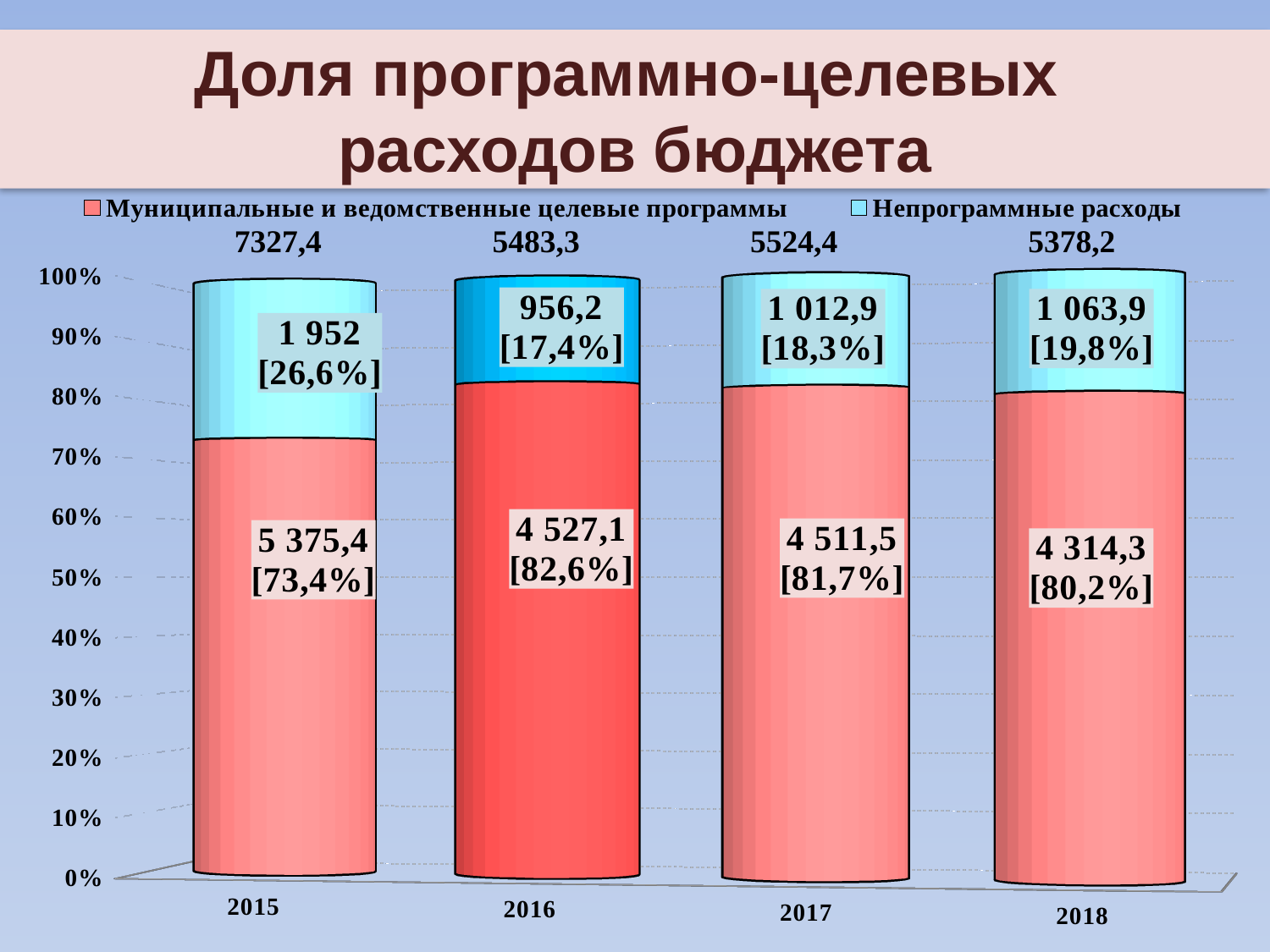
In which year is the value for Непрограммные расходы the lowest? 2016 What percentage share do Муниципальные и ведомственные целевые программы have in 2015? 73,4% What is the value for Непрограммные расходы in 2018? 1 063,9 In which year is the share of Муниципальные и ведомственные целевые программы the highest? 2016 How many series does the legend list? 2 What kind of chart is shown on the slide? Stacked bar chart What is the total shown above the bar for 2015? 7327,4 What percentage share do Непрограммные расходы have in 2017? 18,3% What is the value for Муниципальные и ведомственные целевые программы in 2016? 4 527,1 Which is larger: the value for Муниципальные и ведомственные целевые программы in 2017 or in 2018? 2017 What is the difference between the Непрограммные расходы values for 2018 and 2017? 51,0 How many years are shown on the x axis? 4